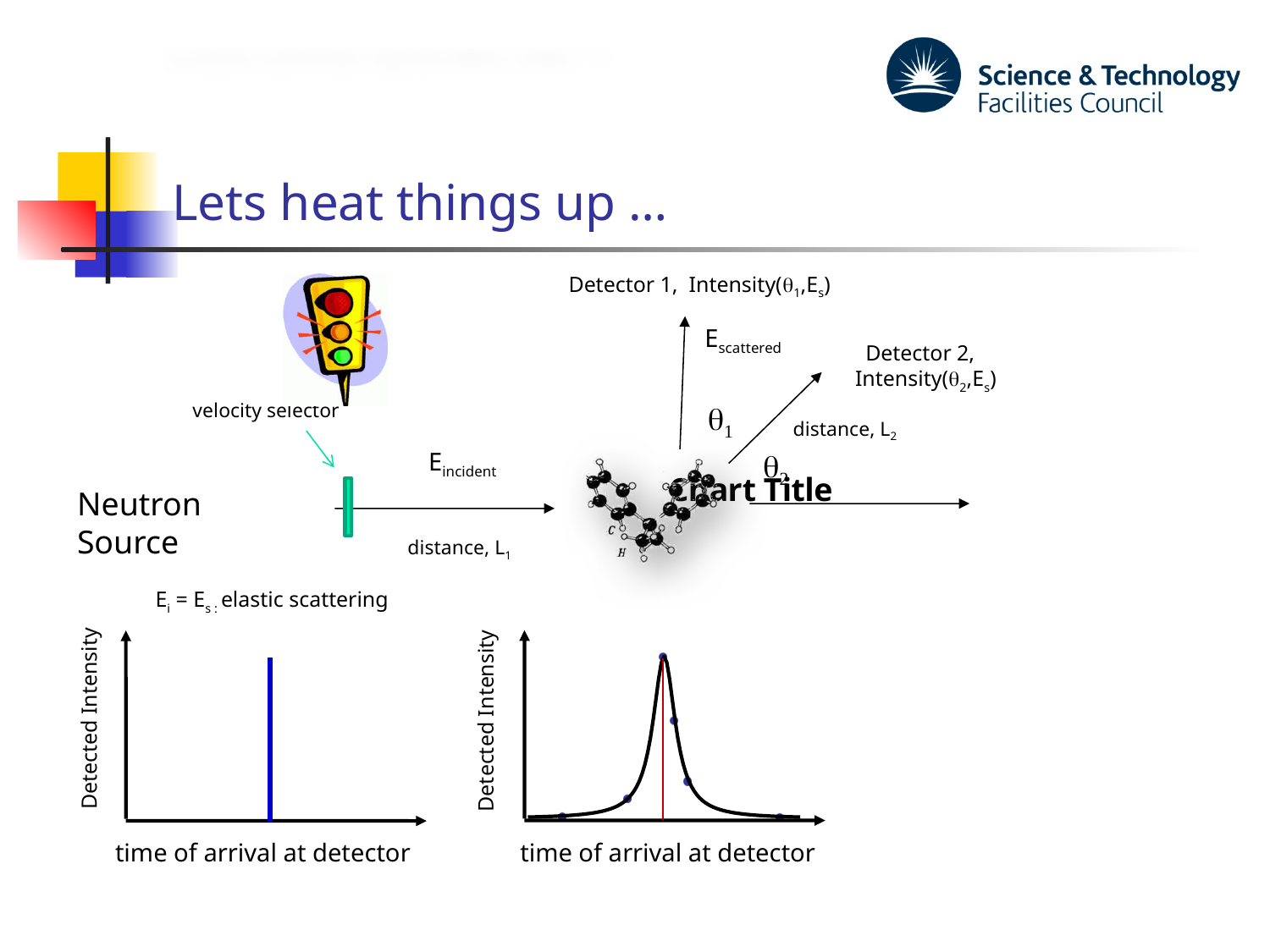
How many peaks does the curve in the bottom-right chart show? 1 What kind of chart is the bottom-right chart (the one with the peaked curve)? line chart What is the x-axis label of the bottom-right chart? time of arrival at detector In the bottom-right chart, does the curve rise or fall along the x axis after the peak? fall How many vertical spikes are plotted in the bottom-left chart? 1 What is the y-axis label of the bottom-left chart? Detected Intensity